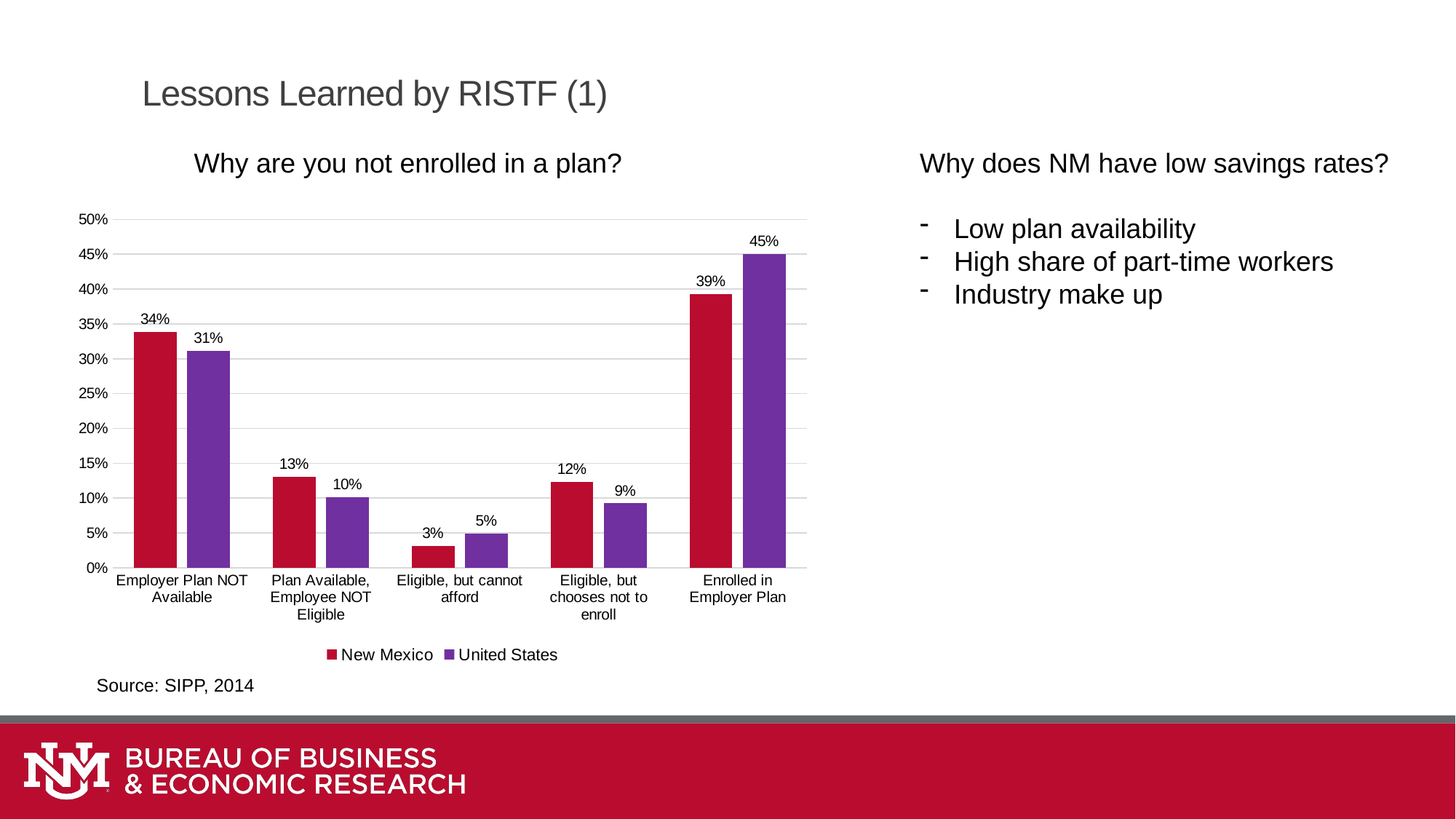
How many categories are shown on the x axis? 5 What is the difference between the United States and New Mexico values for "Enrolled in Employer Plan"? 6% Is the New Mexico value for "Eligible, but chooses not to enroll" greater or less than 10%? greater What is the New Mexico value for "Employer Plan NOT Available"? 34% What is the New Mexico value for "Eligible, but cannot afford"? 3% How many series does the legend list? 2 Which category has the lowest New Mexico value? Eligible, but cannot afford What is the United States value for "Enrolled in Employer Plan"? 45% What kind of chart is shown? bar chart Which category has the highest United States value? Enrolled in Employer Plan What is the title of the chart? Why are you not enrolled in a plan? Which is larger for "Plan Available, Employee NOT Eligible": New Mexico or United States? New Mexico